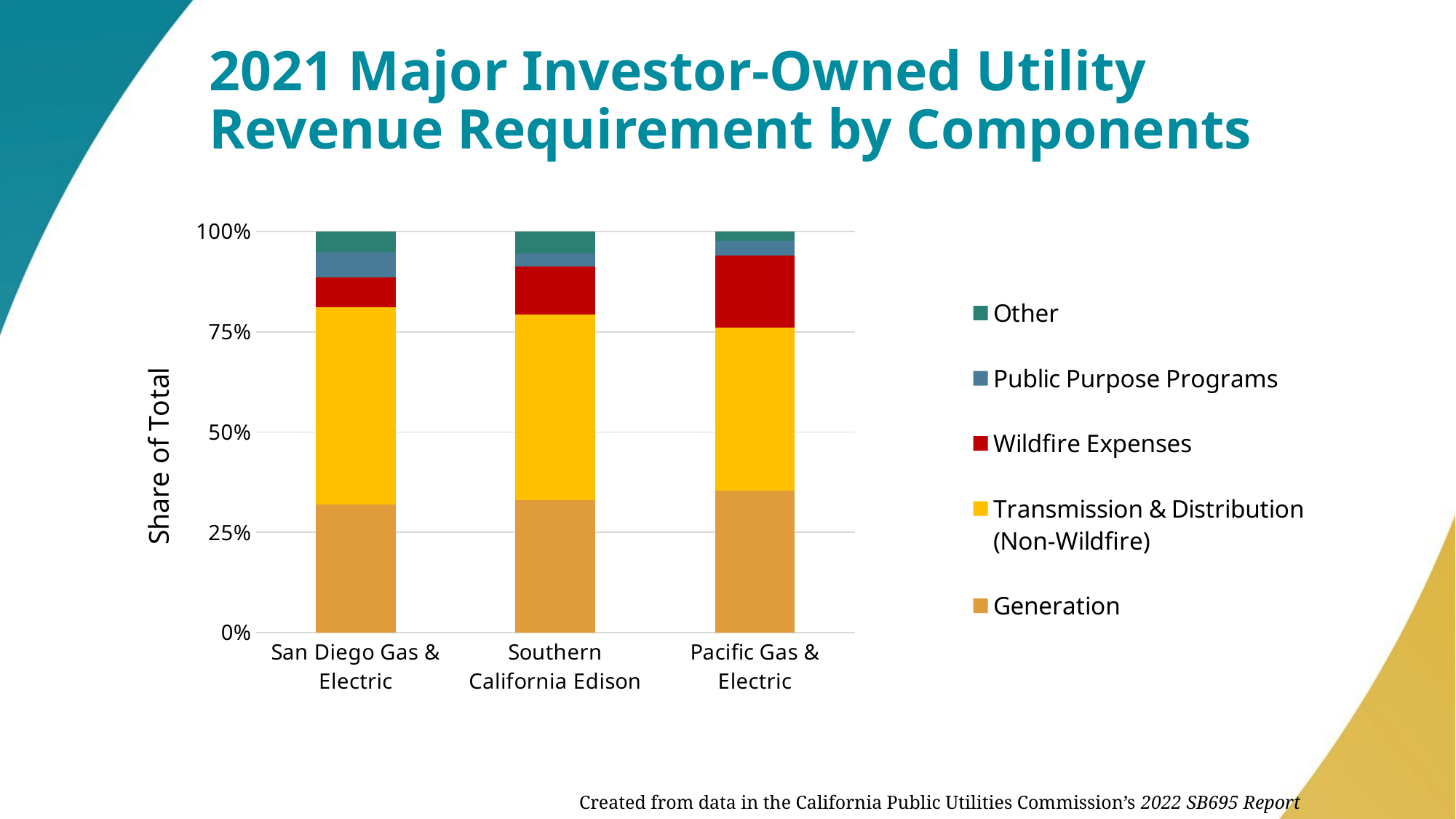
What is the label of the y axis? Share of Total Is the Wildfire Expenses share larger for Pacific Gas & Electric or for San Diego Gas & Electric? Pacific Gas & Electric Which utility has the largest Wildfire Expenses share? Pacific Gas & Electric Which utility has the smallest Wildfire Expenses share? San Diego Gas & Electric How many utilities (categories) are shown on the x axis? 3 What kind of chart is shown on the slide? Stacked bar chart Is the Generation share for Pacific Gas & Electric greater or less than 50%? less Is the combined share of Generation and Transmission & Distribution (Non-Wildfire) for Southern California Edison greater or less than 75%? greater Which legend entry is shown in yellow? Transmission & Distribution (Non-Wildfire) How many series does the legend list? 5 What does each stacked bar total on the y axis? 100% Is the Generation share for San Diego Gas & Electric greater or less than 25%? greater